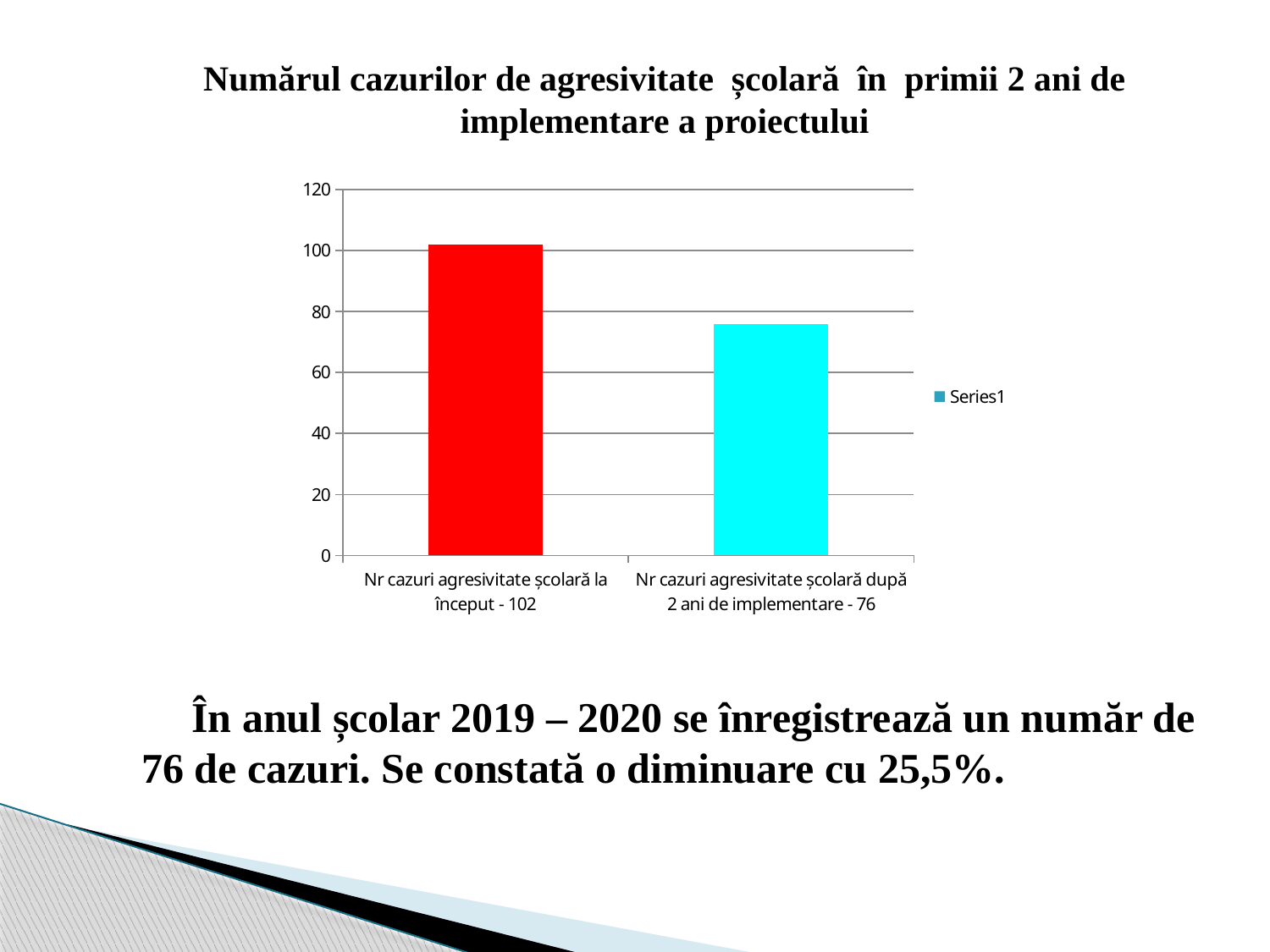
What kind of chart is shown on the slide? bar chart Do the values rise or fall from the first bar to the second bar? fall What is the number of cases of school aggression at the start ("la început"), as printed in the category label? 102 How many bars (categories) does the chart show? 2 Is the value for cases at the start greater or less than 100? greater Which category has the higher number of cases? Nr cazuri agresivitate școlară la început How many series does the legend list? 1 Is the value for cases after 2 years of implementation greater or less than 80? less Which category has the lower number of cases? Nr cazuri agresivitate școlară după 2 ani de implementare By how much did the number of cases decrease from the start to after 2 years of implementation? 26 What is the number of cases of school aggression after 2 years of implementation, as printed in the category label? 76 What is the name of the series shown in the legend? Series1